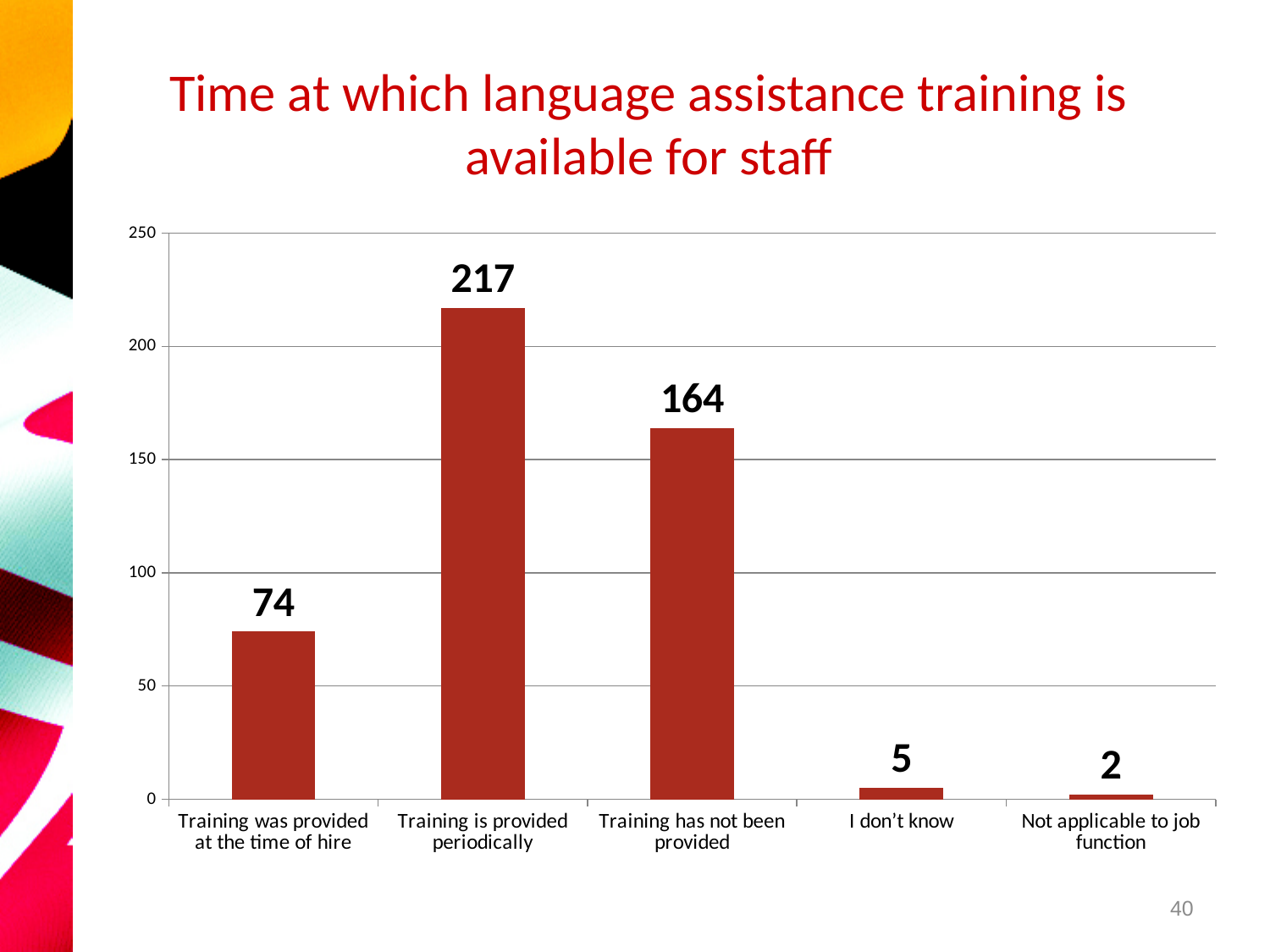
What is the value for "Training is provided periodically"? 217 Which is larger: the value for "Training has not been provided" or the value for "Training was provided at the time of hire"? Training has not been provided What is the value for "I don't know"? 5 Which category has the lowest value? Not applicable to job function How many categories are shown on the x axis? 5 What is the value for "Training was provided at the time of hire"? 74 Which category has the highest value? Training is provided periodically What is the title of the chart? Time at which language assistance training is available for staff What is the difference between the values for "Training is provided periodically" and "Training has not been provided"? 53 What is the value for "Not applicable to job function"? 2 What kind of chart is shown on the slide? Bar chart Is the value for "Training has not been provided" greater or less than 150? greater